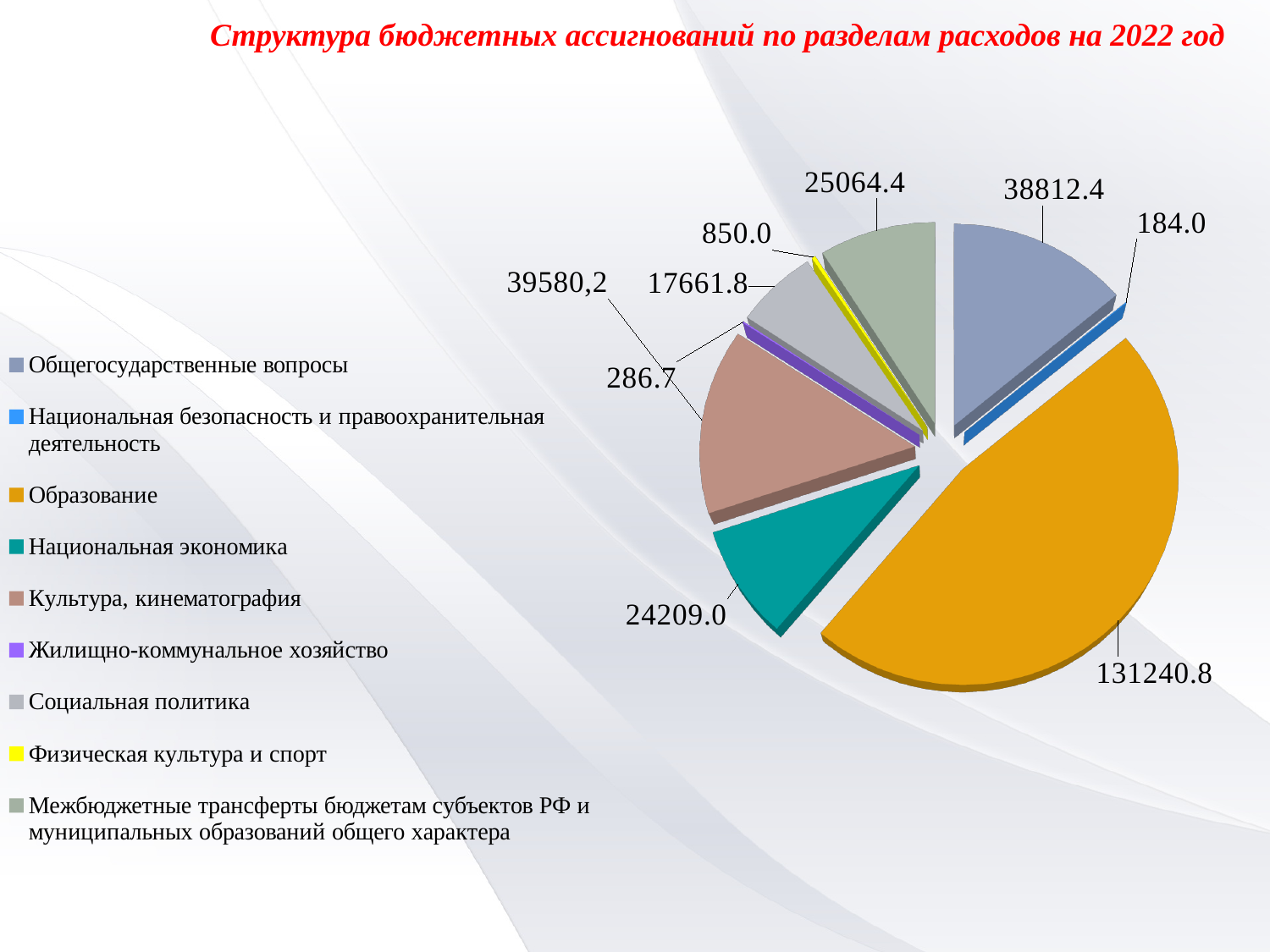
What is the value for Социальная политика? 17661.8 What is the value for Межбюджетные трансферты бюджетам субъектов РФ и муниципальных образований общего характера? 25064.4 How many categories does the legend of the pie chart list? 9 What is the value for Физическая культура и спорт? 850.0 What is the difference between the values for Образование and Общегосударственные вопросы? 92428.4 What is the value for Образование? 131240.8 Which category has the smallest value? Национальная безопасность и правоохранительная деятельность What is the value for Общегосударственные вопросы? 38812.4 What is the value for Национальная экономика? 24209.0 What kind of chart is shown on the slide? Pie chart Which category has the largest slice of the pie? Образование What is the title of the chart? Структура бюджетных ассигнований по разделам расходов на 2022 год